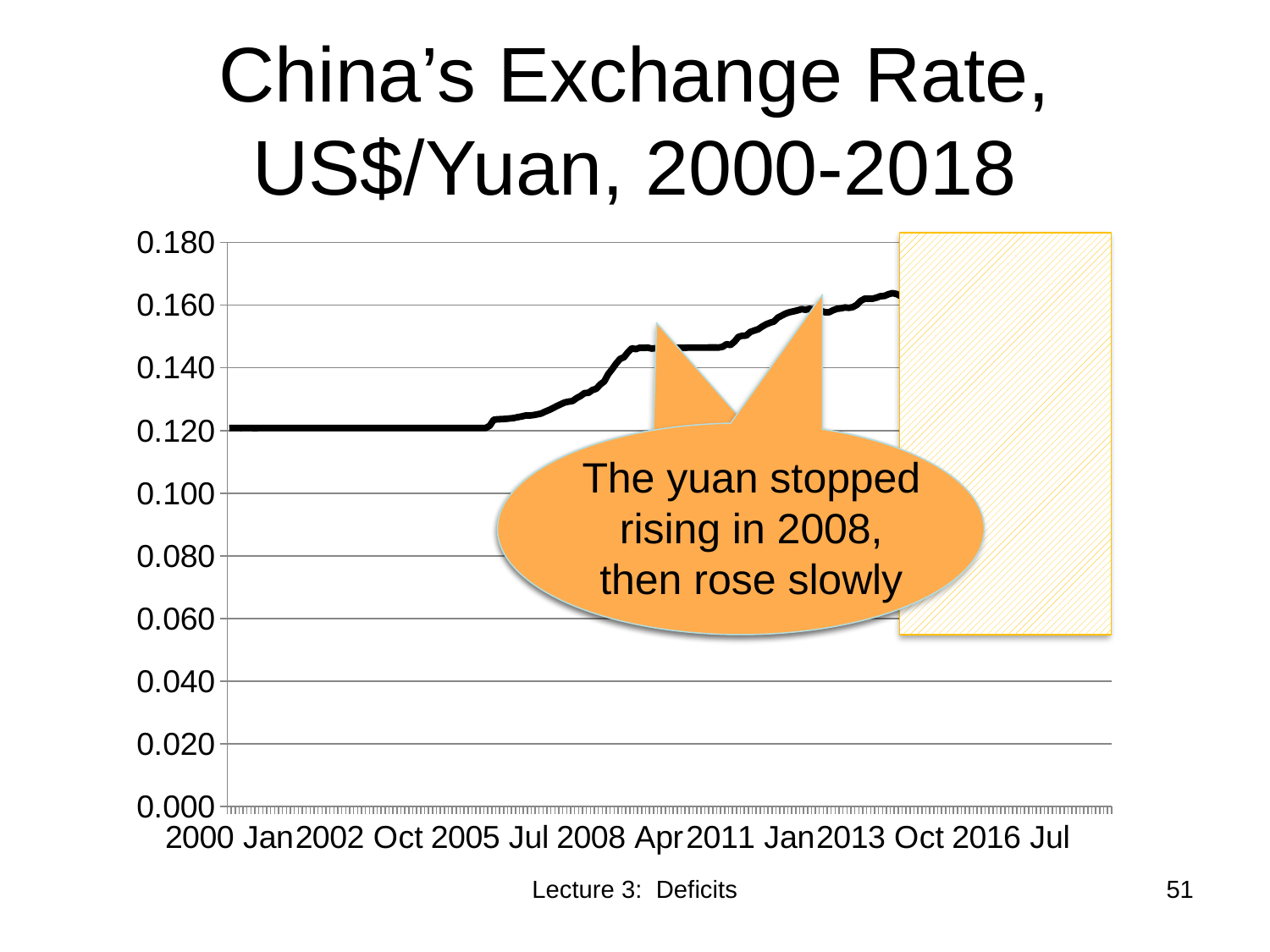
What is the title of the chart? China's Exchange Rate, US$/Yuan, 2000-2018 Is the exchange rate in 2000 Jan greater or less than 0.140? less What kind of chart is shown on the slide? line chart Is the exchange rate in 2000 Jan greater or less than 0.100? greater How many date labels are shown along the x axis? 7 What is the highest value shown on the vertical axis? 0.180 Overall, does the exchange rate rise or fall from 2000 to 2018? rise Is the exchange rate in 2011 Jan greater or less than 0.120? greater Which is larger, the exchange rate in 2002 Oct or in 2008 Apr? 2008 Apr